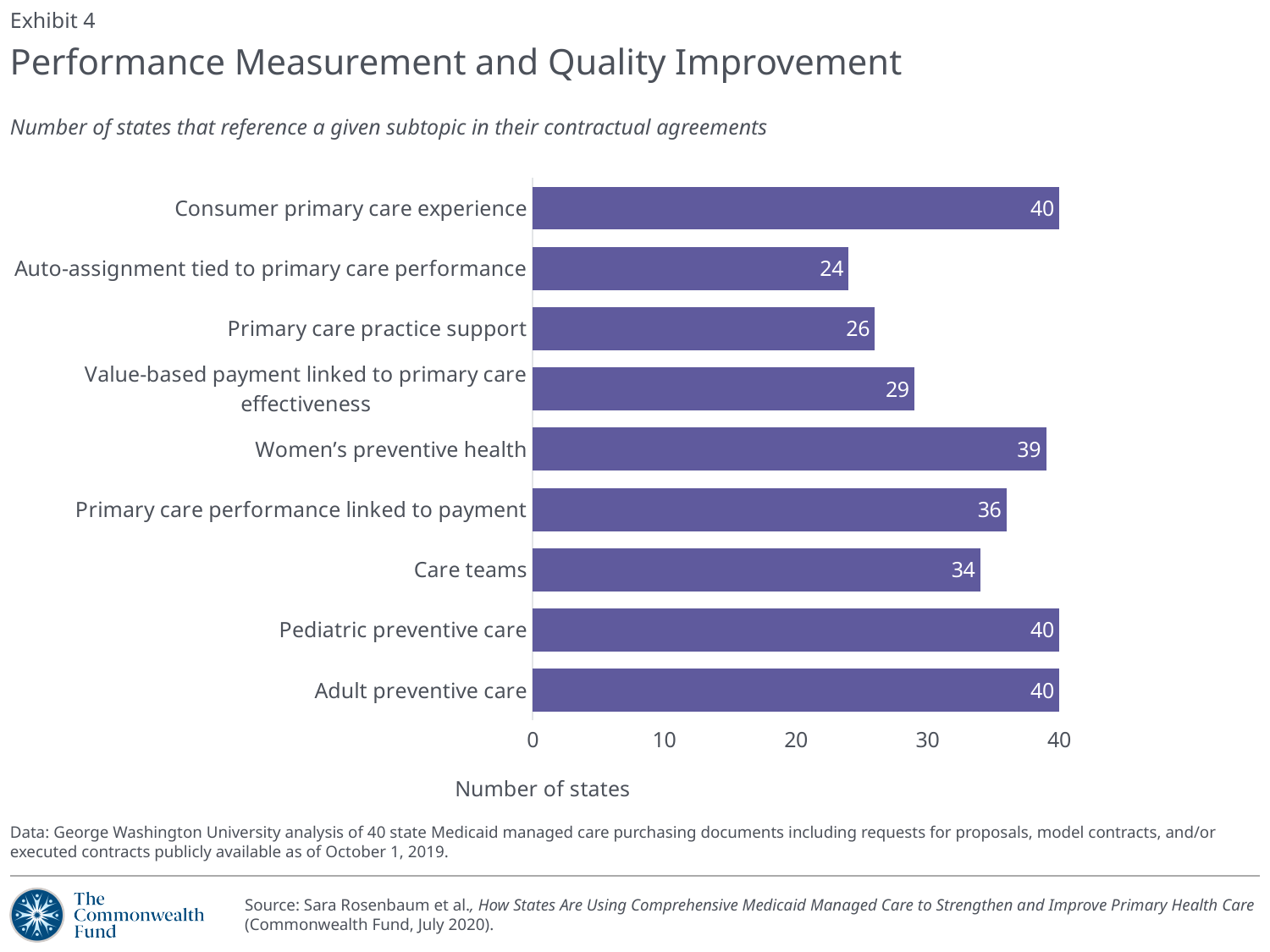
How many subtopics have a value of 40? 3 What is the value for Auto-assignment tied to primary care performance? 24 Which is larger, the value for Primary care performance linked to payment or the value for Care teams? Primary care performance linked to payment How many subtopics are shown in the chart? 9 How many states reference Care teams in their contractual agreements? 34 What is the difference between the values for Pediatric preventive care and Care teams? 6 What is the value for Value-based payment linked to primary care effectiveness? 29 What kind of chart is shown on the slide? bar chart Is the value for Primary care practice support greater or less than 30? less What is the label of the x axis? Number of states Which subtopic has the lowest number of states? Auto-assignment tied to primary care performance What is the difference between the values for Women's preventive health and Primary care practice support? 13